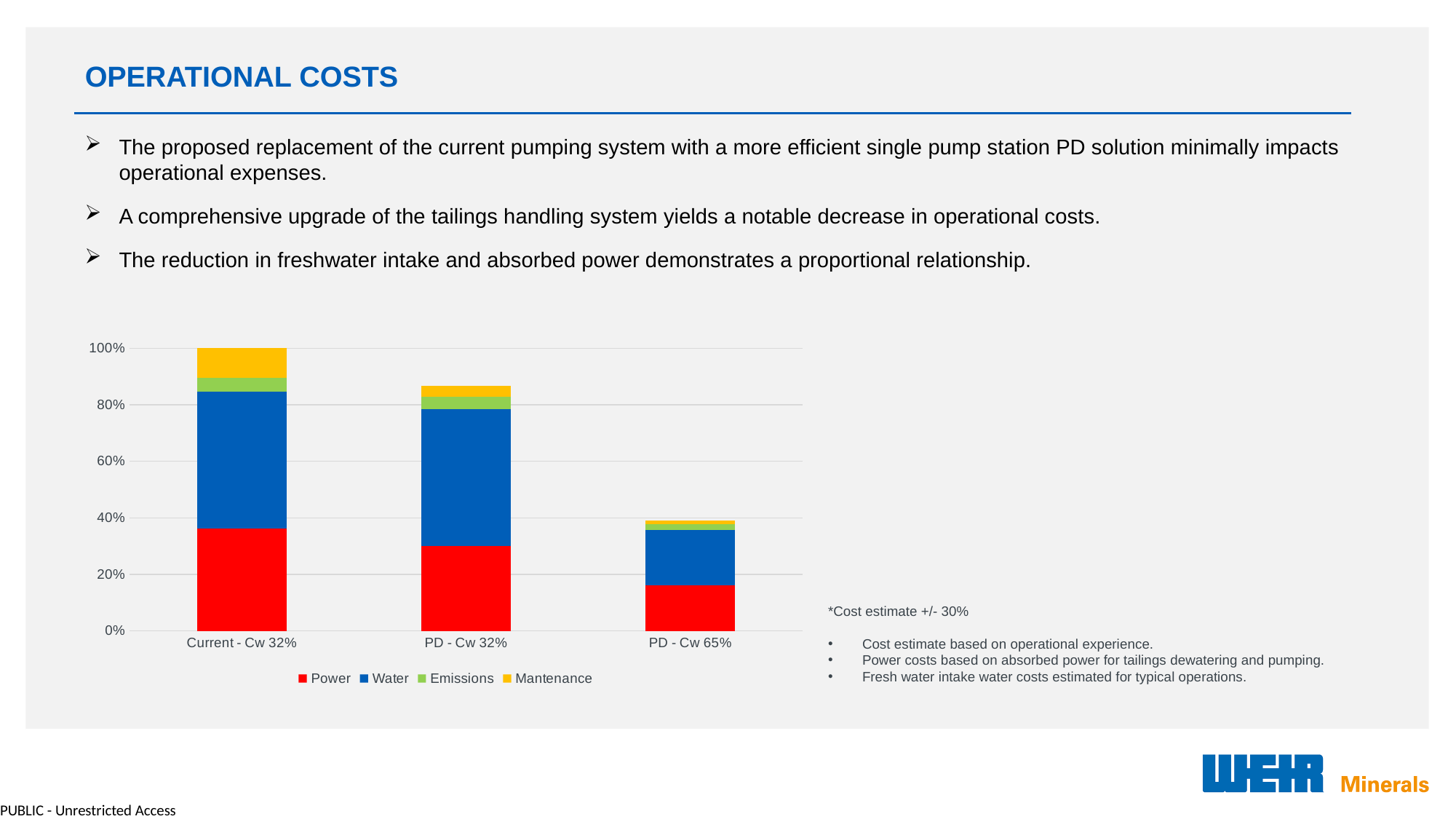
What is the total height of the Current - Cw 32% stacked bar? 100% Is the total for PD - Cw 32% greater or less than 80%? greater Which category has the shortest stacked bar? PD - Cw 65% Which series is shown in red in the chart legend? Power Is the total for PD - Cw 65% greater or less than 60%? less How many series does the chart legend list? 4 Is the Power value for Current - Cw 32% greater or less than 20%? greater Which category has the tallest stacked bar? Current - Cw 32% What kind of chart is shown on the slide? Stacked bar chart How many categories are shown on the x axis of the chart? 3 Do the stacked bar totals rise or fall from left to right across the x axis? Fall Which has the larger total, PD - Cw 32% or PD - Cw 65%? PD - Cw 32%